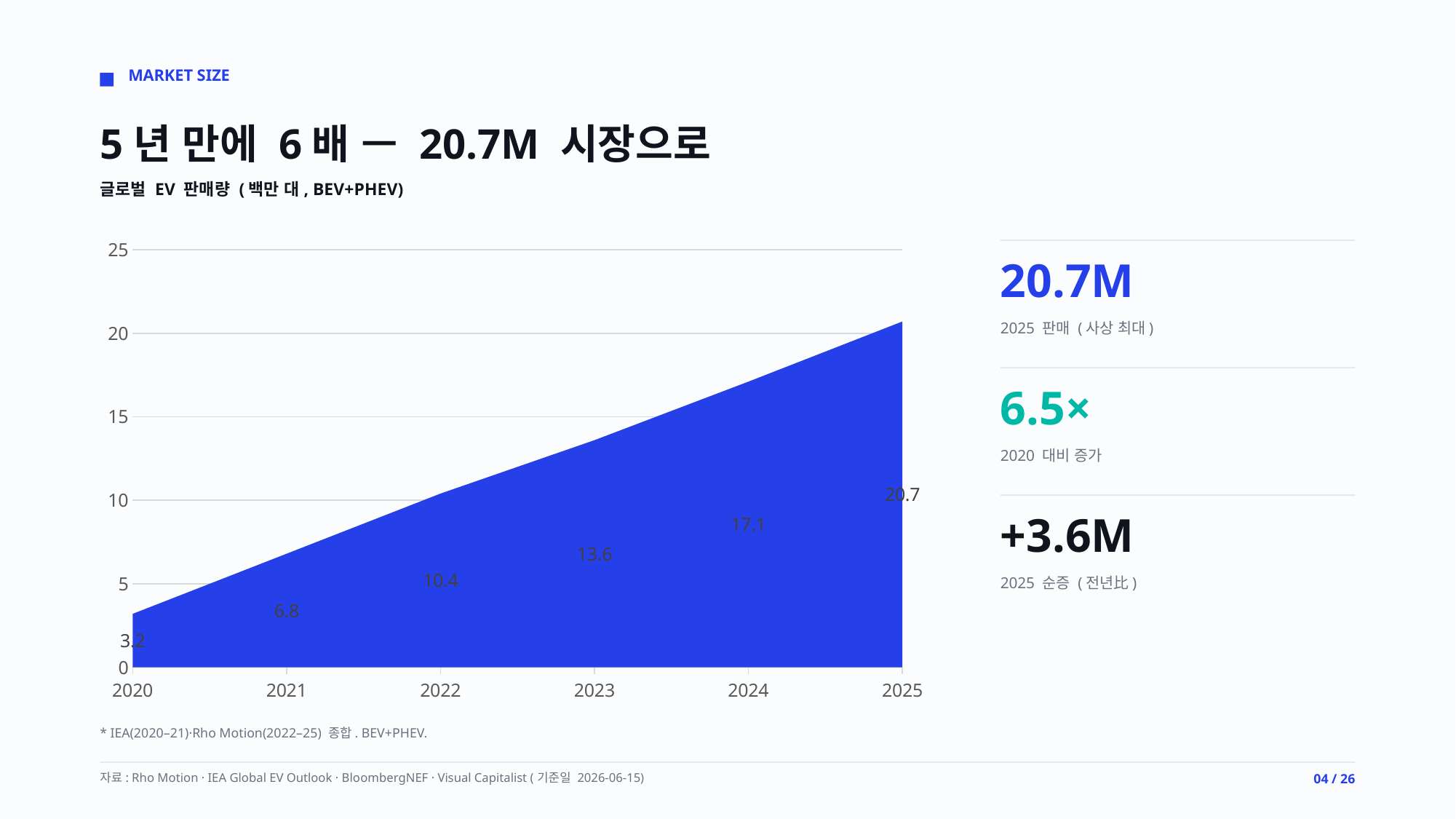
What is the value for 2020? 3.2 What is the difference between the values for 2025 and 2024? 3.6 What kind of chart is shown? area chart Is the value for 2023 greater or less than 15? less What is the value for 2024? 17.1 What is the difference between the values for 2021 and 2020? 3.6 What is the value for 2022? 10.4 Which is larger, the value for 2023 or the value for 2022? 2023 Which year has the lowest value? 2020 How many years are plotted on the chart? 6 Do the values rise or fall from 2020 to 2025? rise Which year has the highest value? 2025